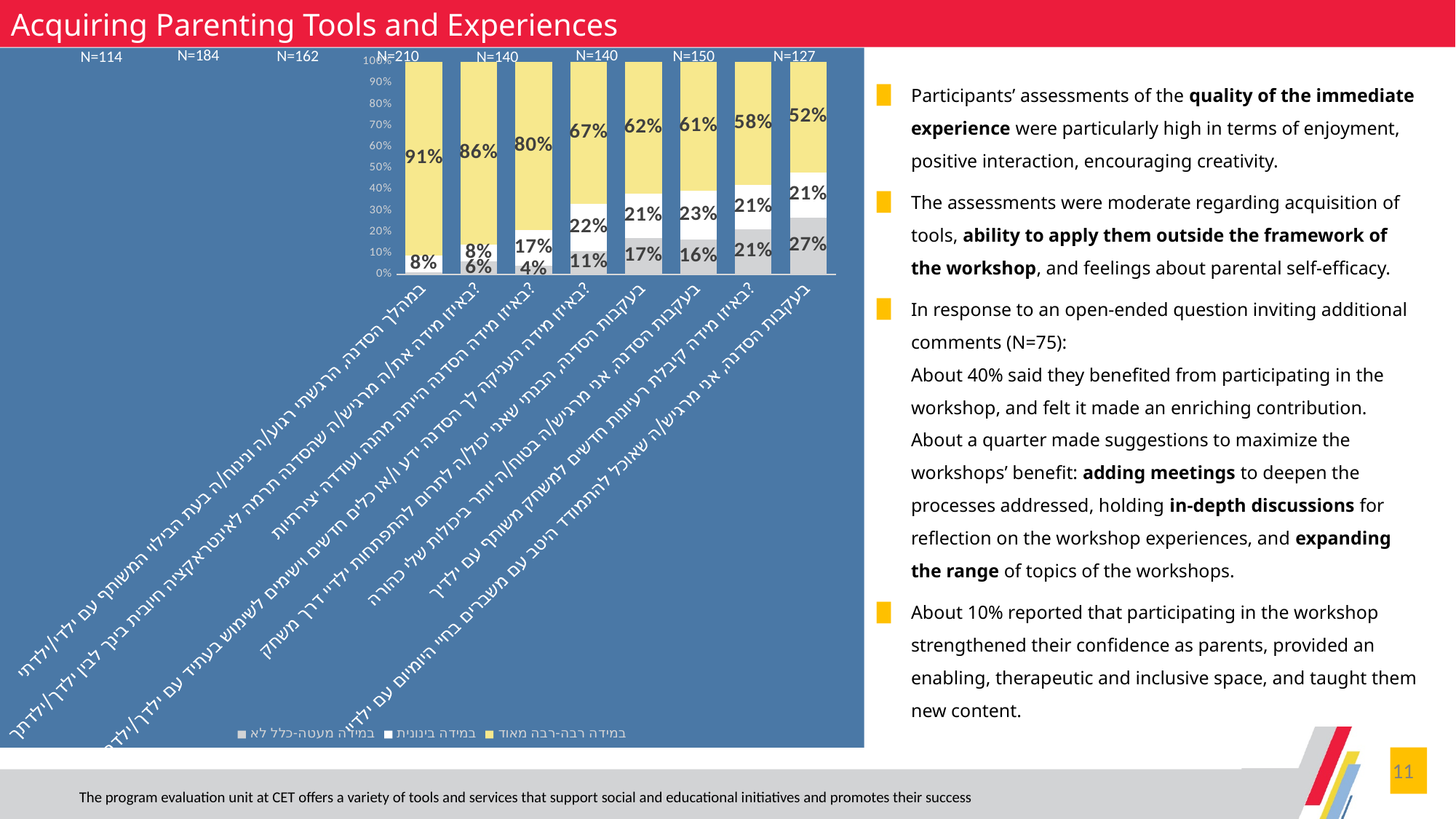
What is the difference between the yellow segment values of the leftmost bar and the rightmost bar? 39 percentage points What is the value of the yellow (top) segment in the rightmost bar? 52% What is the value of the gray (bottom) segment in the rightmost bar? 27% Which bar has the lowest yellow (top) segment value? The rightmost bar (52%) Which bar has the highest yellow (top) segment value? The leftmost bar (91%) Which colour represents the legend entry 'במידה רבה-רבה מאוד'? Yellow What kind of chart is shown on the slide? Stacked bar chart What is the value of the white (middle) segment in the sixth bar from the left? 23% Do the yellow (top) segment values rise or fall moving from left to right across the bars? Fall How many series does the chart legend list? 3 How many bars (categories) are plotted in the chart? 8 What is the value of the yellow (top) segment in the leftmost bar? 91%